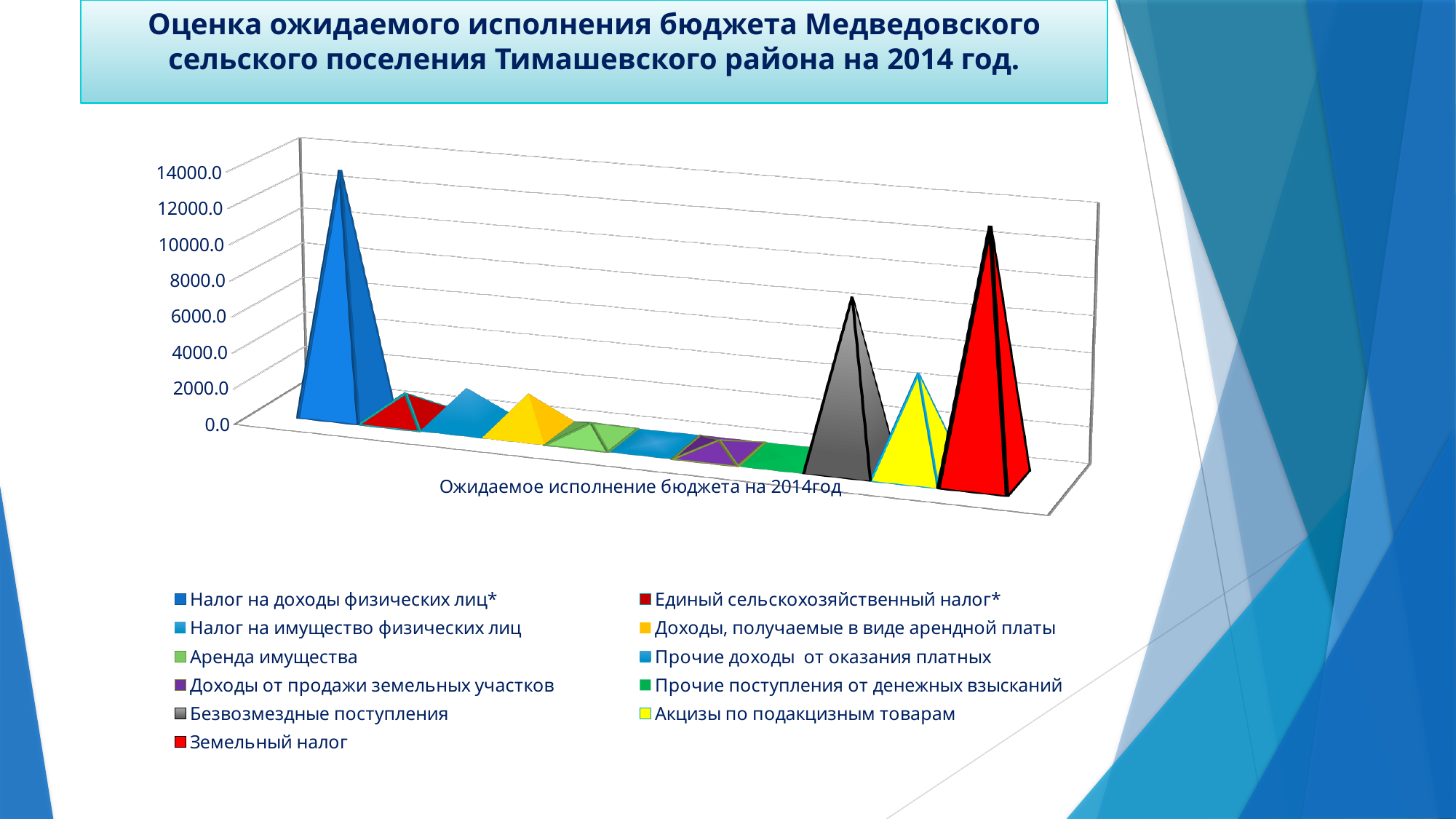
Is the value for Налог на доходы физических лиц* greater or less than 12000.0? greater Which is larger, Налог на доходы физических лиц* or Земельный налог? Налог на доходы физических лиц* What colour represents Земельный налог in the legend? red How many series does the legend list? 11 Is the value for Земельный налог greater or less than 8000.0? greater What kind of chart is shown on the slide? bar chart Which is larger, Земельный налог or Безвозмездные поступления? Земельный налог Is the value for Безвозмездные поступления greater or less than 4000.0? greater What is the category label shown on the x axis? Ожидаемое исполнение бюджета на 2014год Which series has the highest value? Налог на доходы физических лиц* How many categories are shown on the x axis? 1